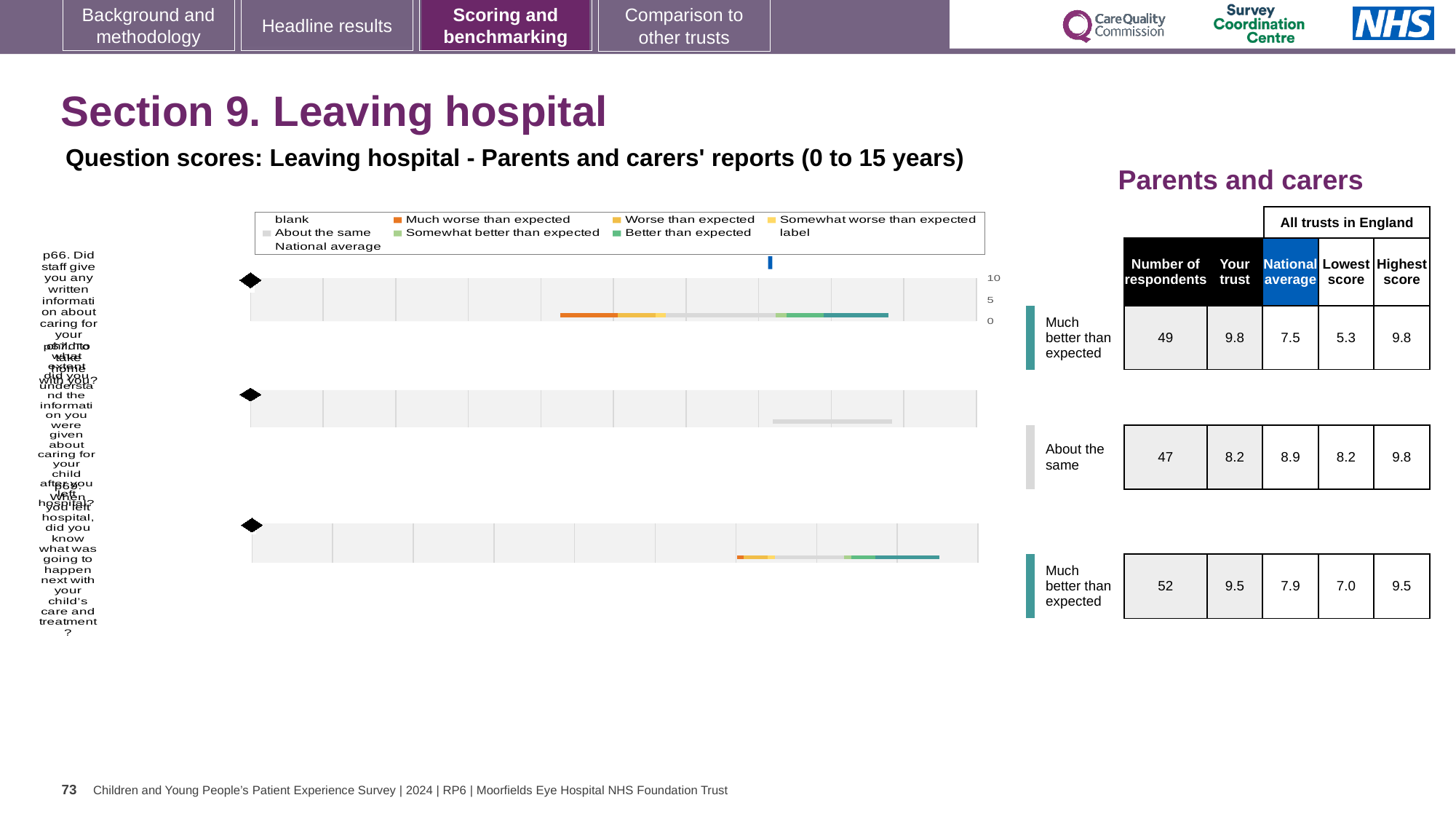
How many respondents answered the third (bottom) question? 52 How many question rows (bars) are plotted in the chart? 3 What is the national average for the second (middle) question row? 8.9 What is the 'Your trust' score for the first (top) question row? 9.8 What is the lowest score across all trusts in England for the first (top) question row? 5.3 What benchmark category is given for the third (bottom) question row? Much better than expected Which question row has the highest number of respondents? the third (bottom) row What is the highest value shown on the chart's score axis? 10 Which question row has the lowest 'Your trust' score? the second (middle) row For the second (middle) question row, which is larger: the 'Your trust' score or the national average? National average What kind of chart is shown on the slide? bar chart What is the difference between the 'Your trust' score and the national average for the first (top) question row? 2.3